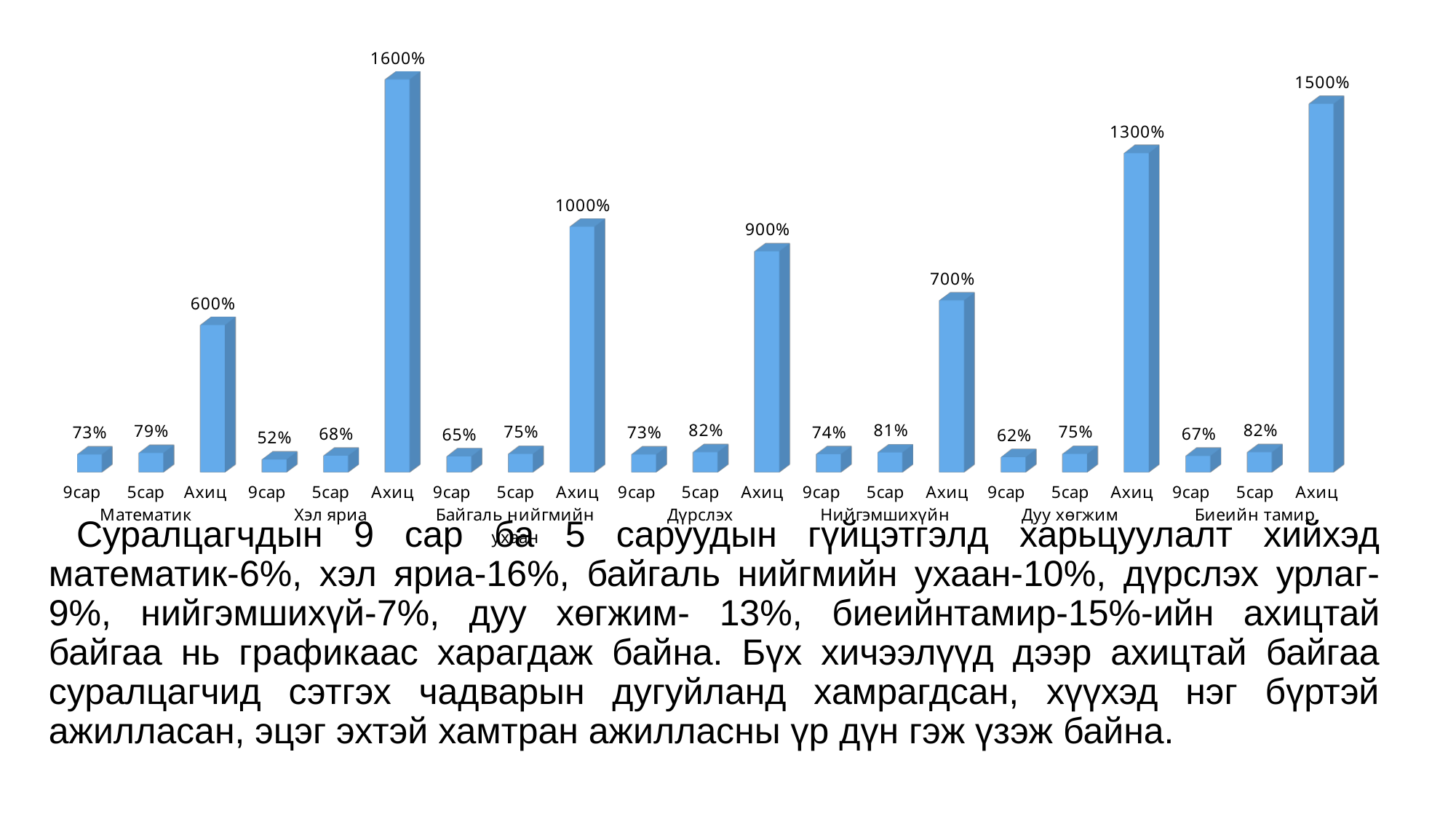
What is the value for 9сар under Дуу хөгжим? 62% What is the value for 9сар under Математик? 73% What is the difference between the 5сар and 9сар values for Хэл яриа? 16% How many subject groups are shown on the chart? 7 Which subject has the lowest 9сар value? Хэл яриа Which subject has the lowest Ахиц value? Математик Which subject has the highest Ахиц value? Хэл яриа What kind of chart is shown on the slide? Bar chart What is the Ахиц value for Биеийн тамир? 1500% Which is larger: the Ахиц value for Дуу хөгжим or the Ахиц value for Нийгэмшихүйн? Дуу хөгжим What is the Ахиц value for Хэл яриа? 1600% What is the value for 5сар under Дүрслэх? 82%